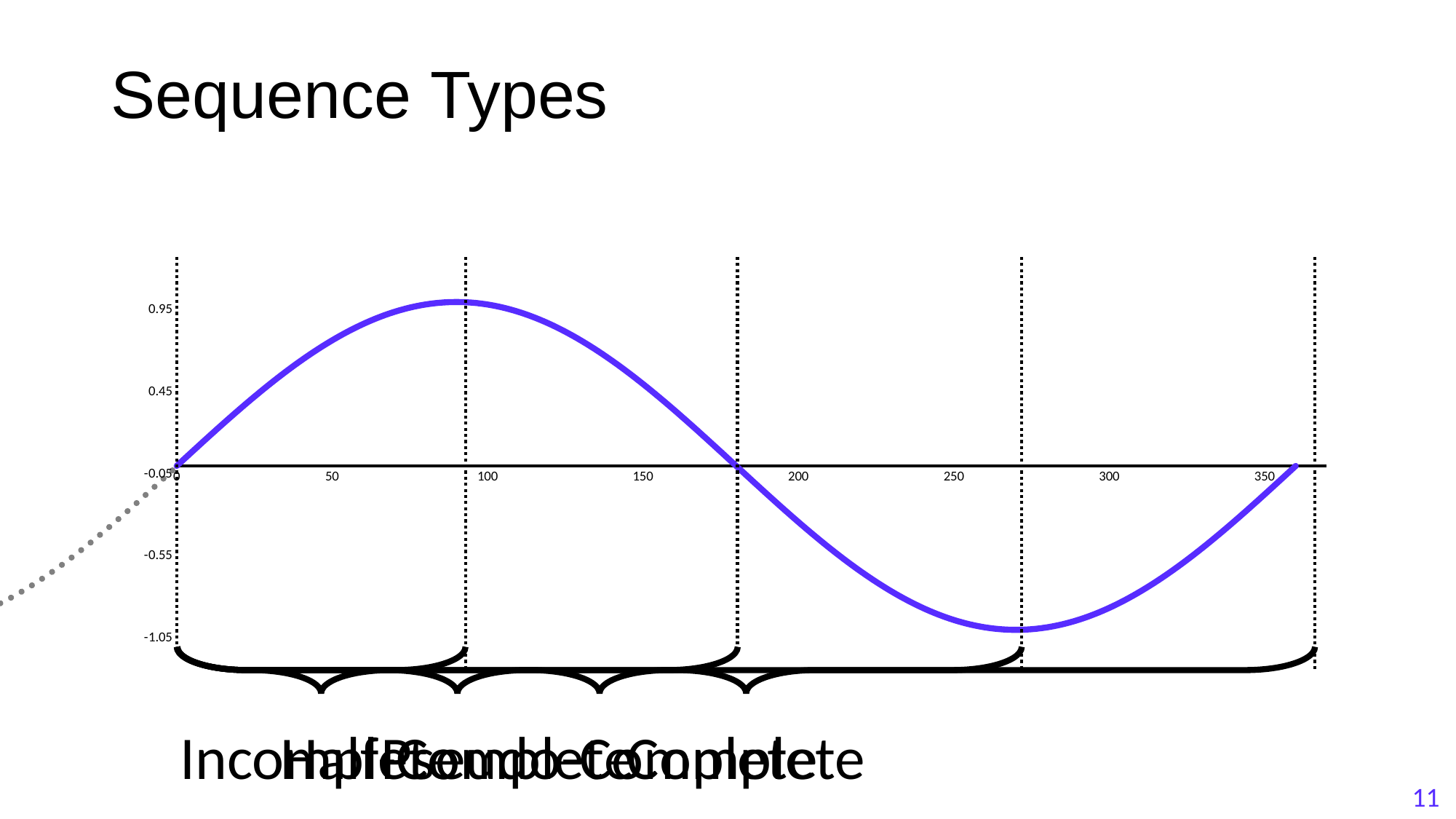
Is the value of the line at x = 50 greater or less than 0.45? greater What kind of chart is shown on the slide? line chart Which is larger, the value of the line at x = 50 or at x = 250? x = 50 How many tick labels are shown on the x axis of the chart? 8 What is the lowest tick label shown on the y axis of the chart? -1.05 What is the highest tick label shown on the y axis of the chart? 0.95 Is the value of the line at x = 200 greater or less than -0.55? greater Is the value of the line at x = 300 greater or less than -0.55? less Does the line rise or fall between x = 100 and x = 250? fall How many data series are plotted on the chart? 1